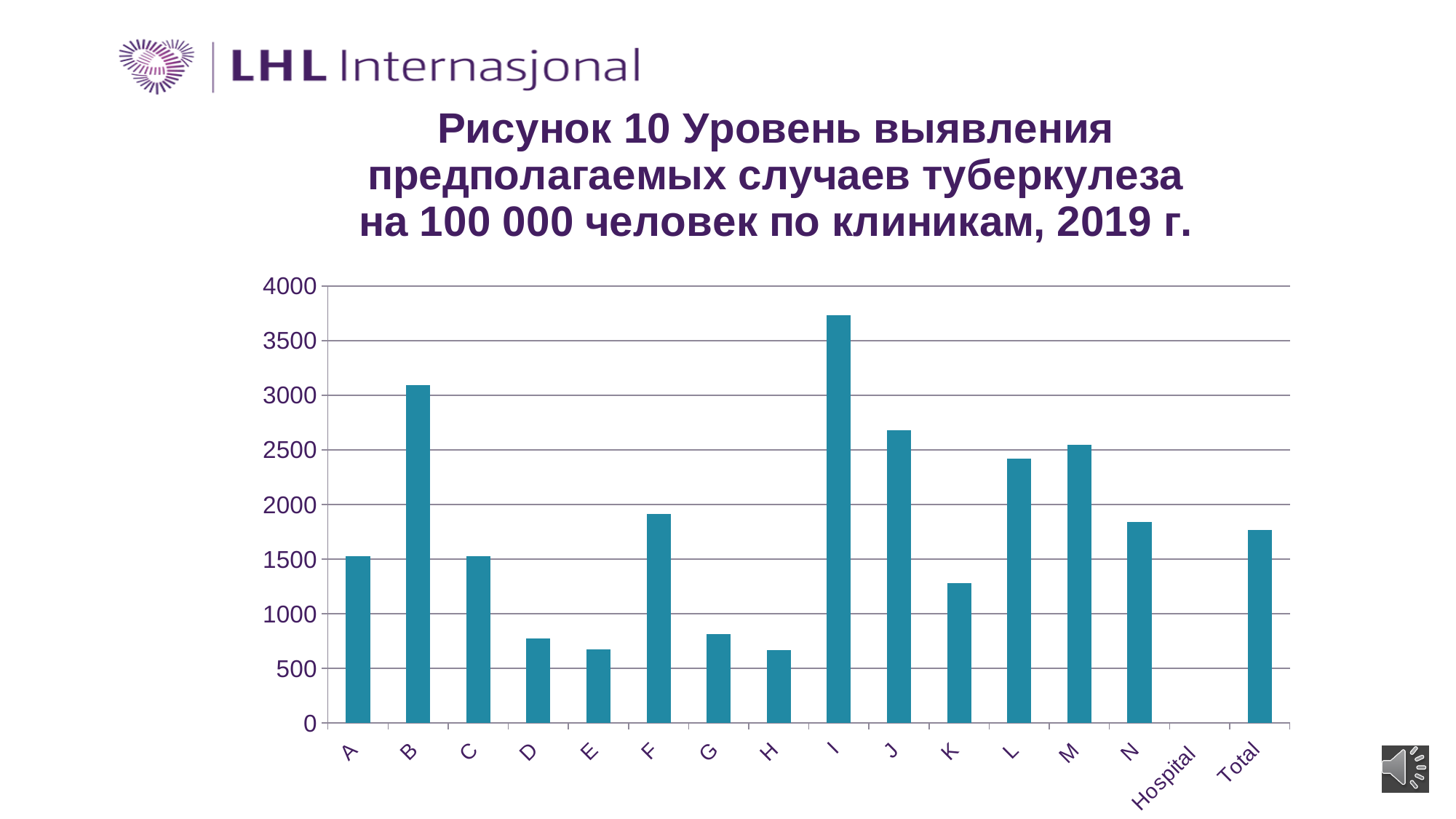
Which has the larger value, clinic J or clinic L? J How many categories are shown along the x axis of the chart? 16 Is the value for clinic L greater or less than 2000? greater Is the value for clinic K greater or less than 1000? greater What is the highest value shown on the y axis of the chart? 4000 Is the value for clinic I greater or less than 3500? greater Which clinic has the highest detection rate on the chart? I What kind of chart is shown on the slide? bar chart Which has the larger value, clinic B or clinic I? I